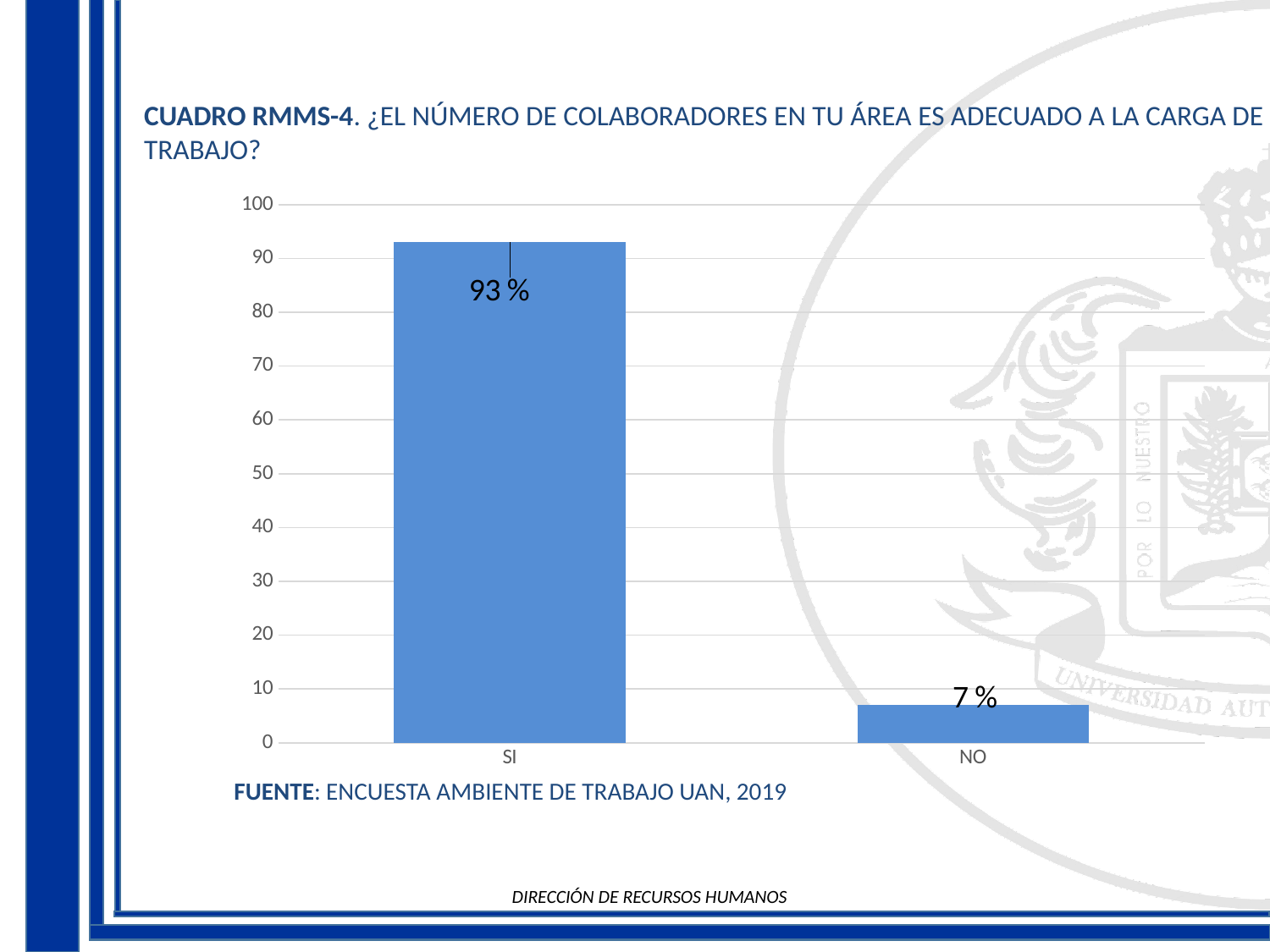
Which category has the lowest value? NO Which is larger, the value for SI or the value for NO? SI Is the value for SI greater or less than 90? greater Which category has the highest value? SI What kind of chart is shown on the slide? bar chart What is the difference between the values for SI and NO? 86 % What is the source cited below the chart? ENCUESTA AMBIENTE DE TRABAJO UAN, 2019 How many categories are shown on the x axis? 2 What is the highest value shown on the y axis? 100 Is the value for NO greater or less than 10? less What is the value for NO? 7 % What is the value for SI? 93 %